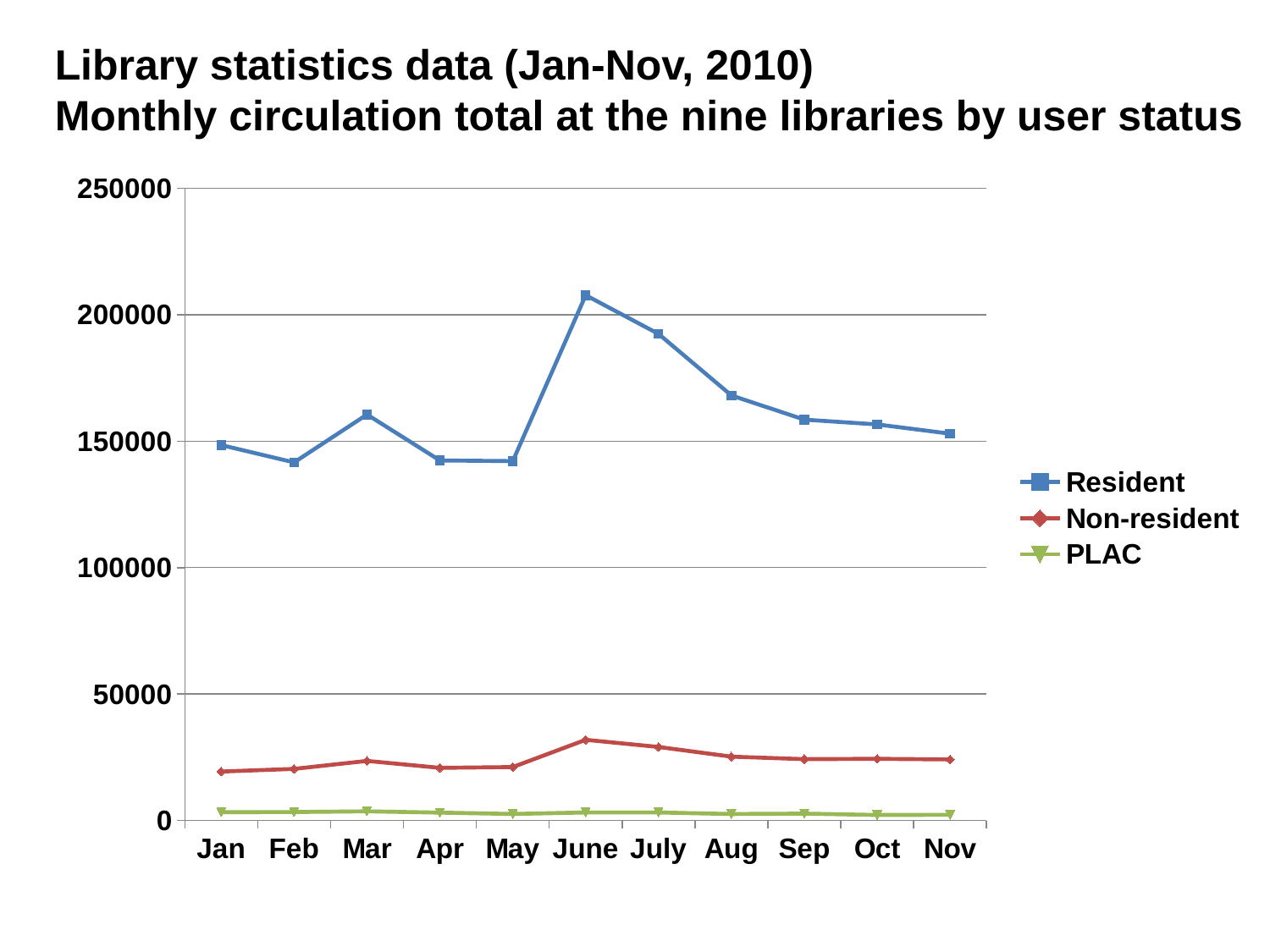
In which month does the Non-resident series reach its highest value? June Is the Resident value for June greater or less than 200000? greater Is the Resident value for Mar greater or less than 150000? greater How many months are plotted along the x axis? 11 Does the Resident series rise or fall from June to Nov? fall Is the Resident value for Feb greater or less than 150000? less How many series does the legend list? 3 Which series has the larger value in Aug, Resident or Non-resident? Resident Which series is shown with green triangle markers? PLAC In which month does the Resident series reach its highest value? June What kind of chart is shown on the slide? line chart